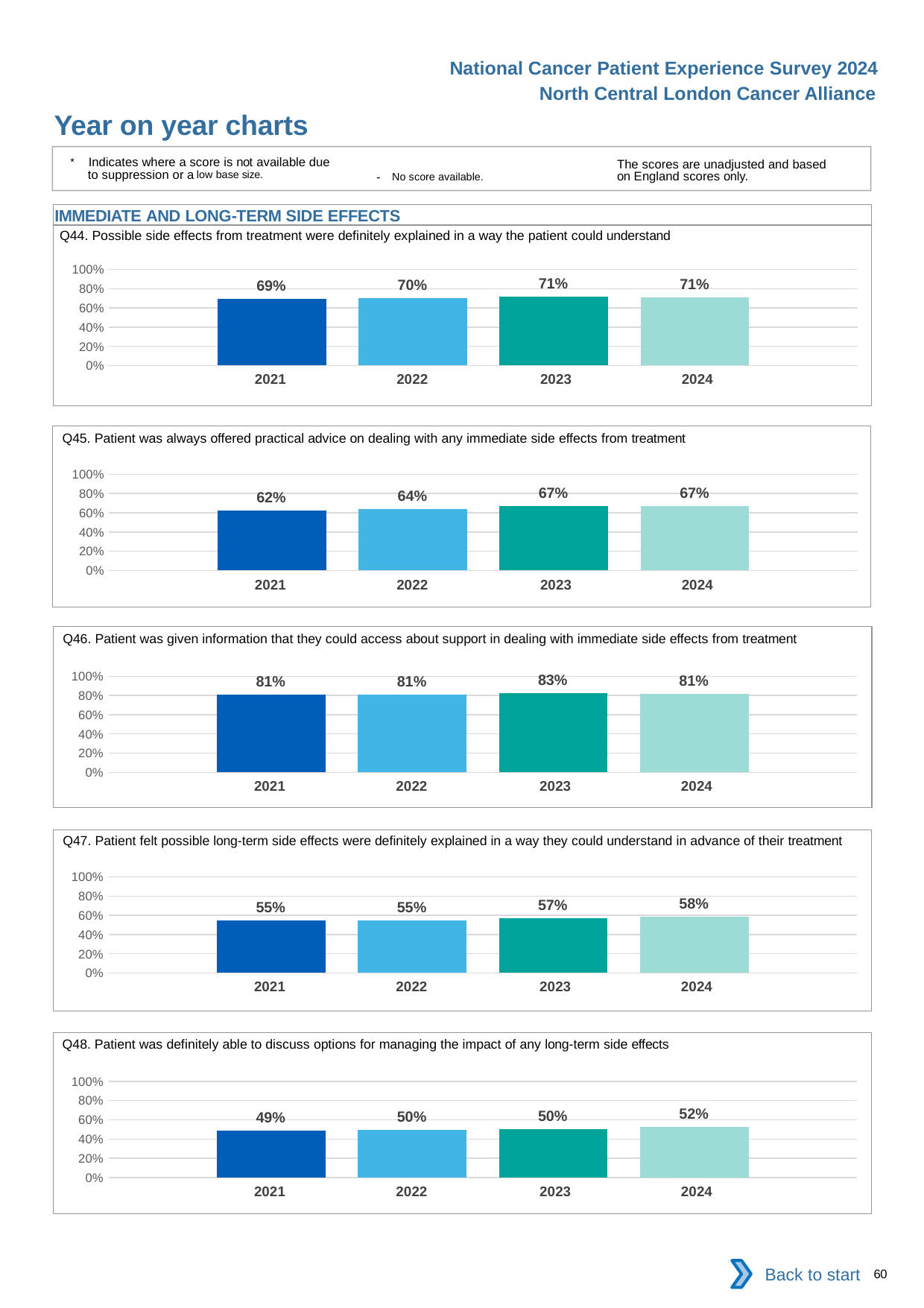
In the Q47 chart, what is the difference between the 2024 value and the 2021 value? 3% How many years are shown in the Q44 chart? 4 In the Q45 chart, do the values rise or fall from 2021 to 2023? rise In the Q45 chart, what is the value for 2024? 67% In the Q48 chart, which year has the lowest value? 2021 In the Q45 chart, what is the difference between the 2023 value and the 2021 value? 5% What is the section heading above the Q44 chart? IMMEDIATE AND LONG-TERM SIDE EFFECTS What kind of chart is the Q46 chart? bar chart In the Q46 chart, which year has the highest value? 2023 In the Q47 chart, which is larger, the value for 2022 or the value for 2023? 2023 In the Q48 chart, is the value for 2024 greater or less than 60%? less In the Q44 chart, what is the value for 2021? 69%